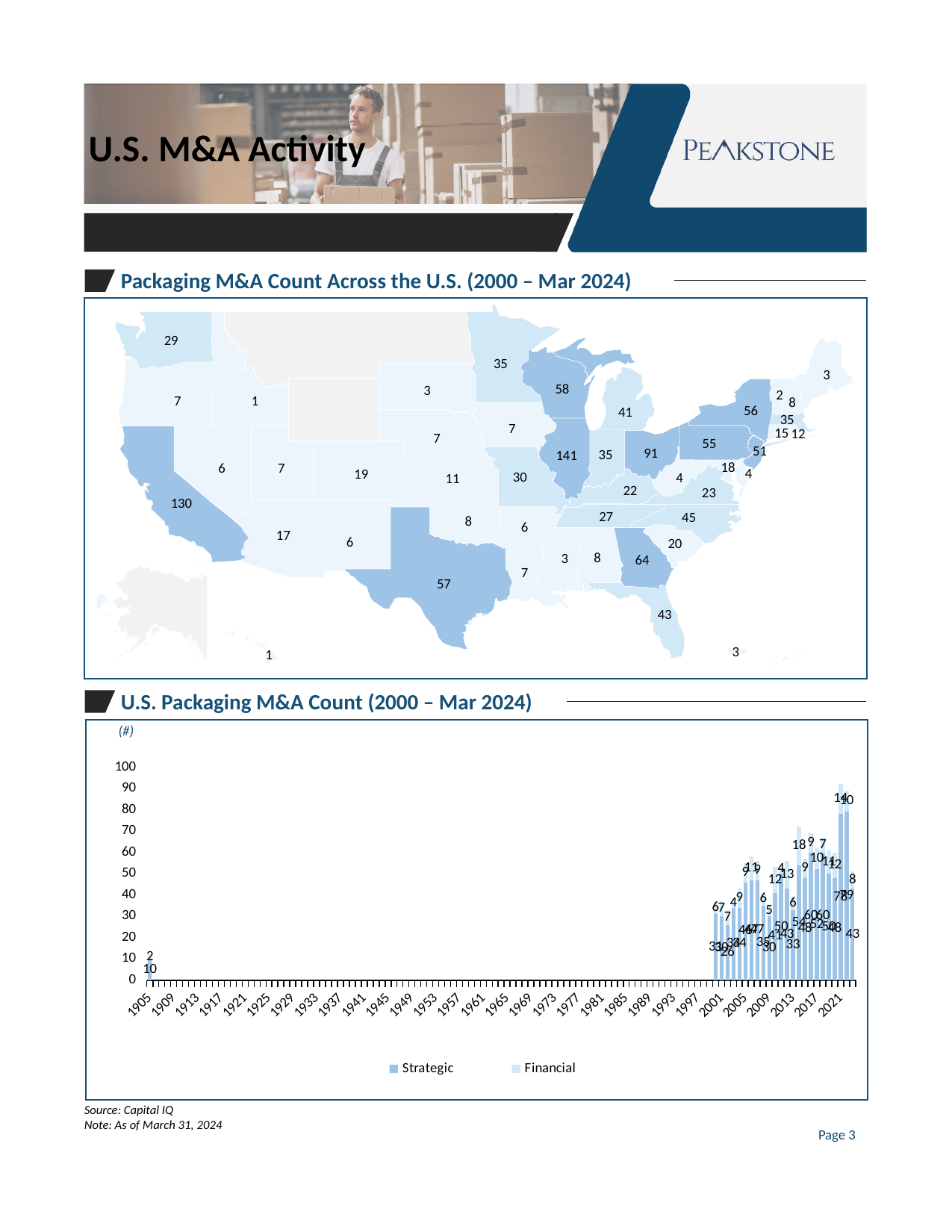
On the map chart 'Packaging M&A Count Across the U.S. (2000 – Mar 2024)', which state has the highest count? Illinois On the map chart 'Packaging M&A Count Across the U.S. (2000 – Mar 2024)', what is the count shown for Ohio? 91 On the map chart 'Packaging M&A Count Across the U.S. (2000 – Mar 2024)', what is the count shown for Florida? 43 What kind of chart is 'U.S. Packaging M&A Count (2000 – Mar 2024)'? Stacked bar chart On the map chart 'Packaging M&A Count Across the U.S. (2000 – Mar 2024)', which has a higher count, Wisconsin or Texas? Wisconsin On the map chart 'Packaging M&A Count Across the U.S. (2000 – Mar 2024)', what is the count shown for Texas? 57 On the map chart 'Packaging M&A Count Across the U.S. (2000 – Mar 2024)', what is the count shown for Illinois? 141 On the map chart 'Packaging M&A Count Across the U.S. (2000 – Mar 2024)', what is the count shown for Georgia? 64 On the map chart 'Packaging M&A Count Across the U.S. (2000 – Mar 2024)', what is the difference between the counts for Illinois and California? 11 On the chart 'U.S. Packaging M&A Count (2000 – Mar 2024)', is the total bar height for 2021 greater or less than 70? greater On the map chart 'Packaging M&A Count Across the U.S. (2000 – Mar 2024)', what is the count shown for California? 130 How many series does the legend of the chart 'U.S. Packaging M&A Count (2000 – Mar 2024)' list? 2